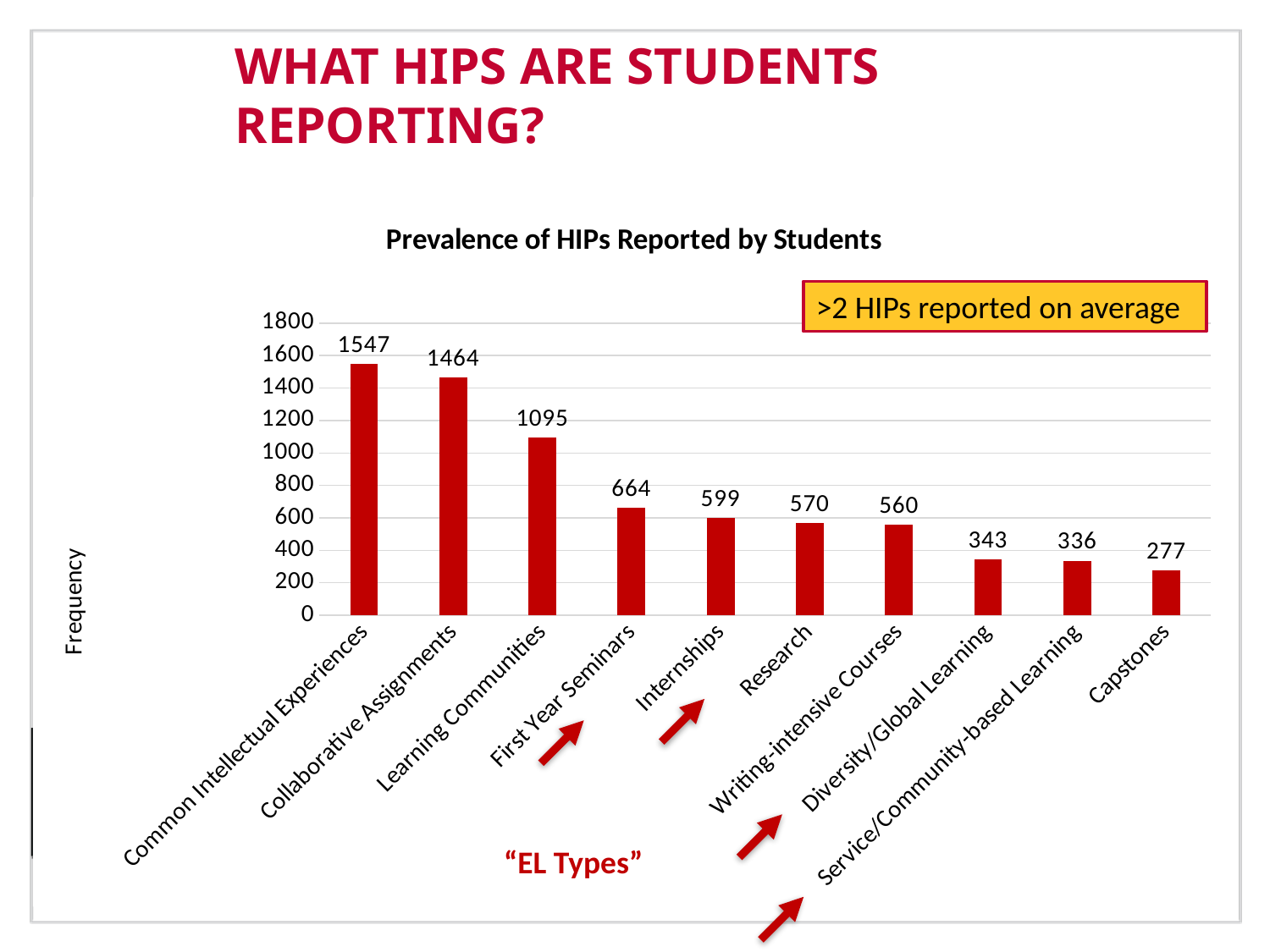
What is the title of the chart? Prevalence of HIPs Reported by Students What is the value for Learning Communities? 1095 Do the values rise or fall from left to right along the x axis? Fall What is the value for Capstones? 277 Which is larger, the value for Research or the value for Writing-intensive Courses? Research What is the difference between the values for Common Intellectual Experiences and Collaborative Assignments? 83 What is the value for Internships? 599 How many categories are shown on the x axis? 10 Which category has the highest value? Common Intellectual Experiences Which category has the lowest value? Capstones What is the value for Common Intellectual Experiences? 1547 What kind of chart is this? Bar chart